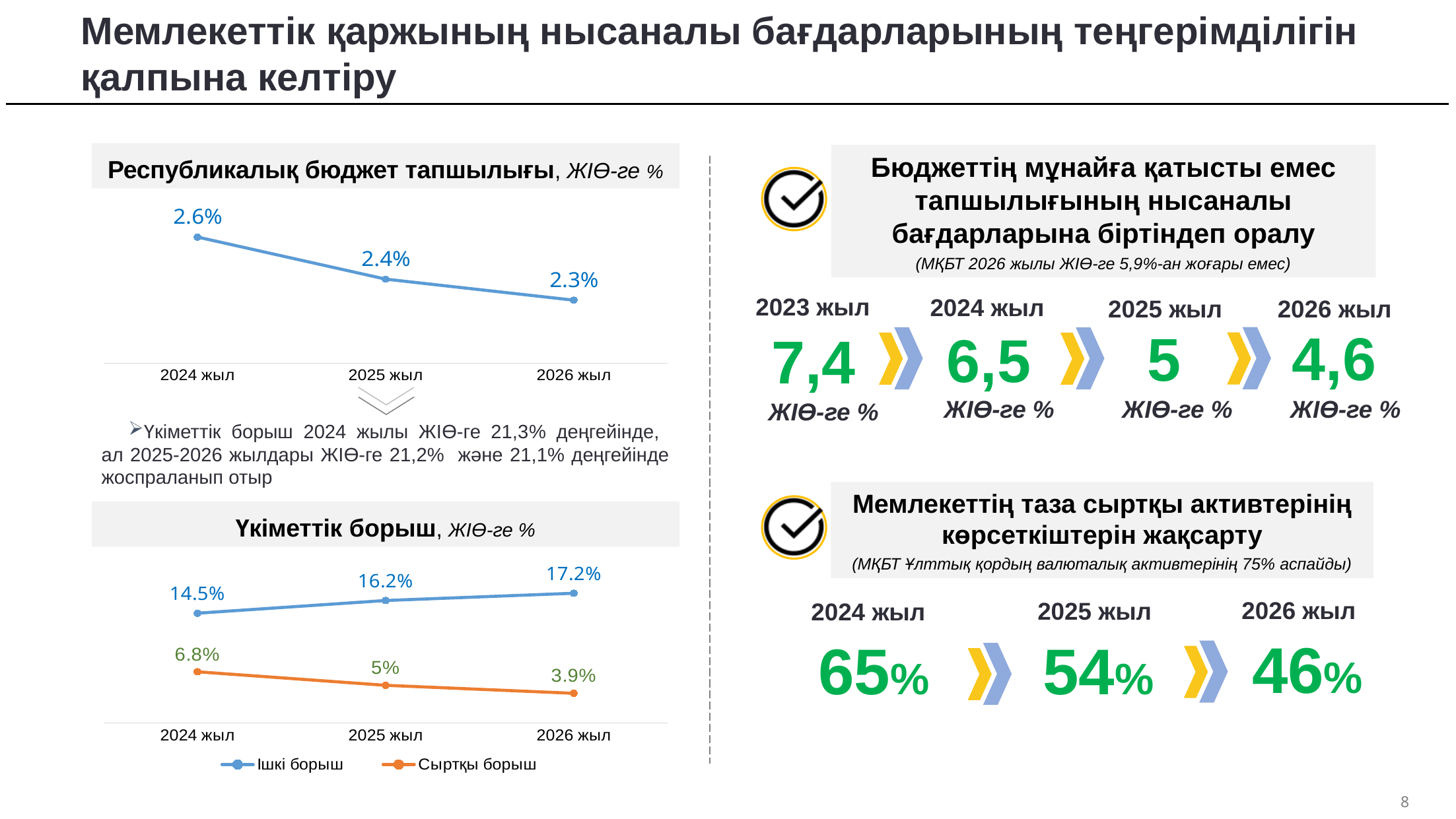
In the 'Республикалық бюджет тапшылығы' chart, what is the value for 2024 жыл? 2.6% In the 'Республикалық бюджет тапшылығы' chart, what is the value for 2026 жыл? 2.3% In the 'Үкіметтік борыш' chart, which series is shown in orange? Сыртқы борыш In the 'Үкіметтік борыш' chart, what is the value of Сыртқы борыш for 2026 жыл? 3.9% In the 'Үкіметтік борыш' chart, how many series does the legend list? 2 In the 'Үкіметтік борыш' chart, which year has the highest value for Ішкі борыш? 2026 жыл In the 'Үкіметтік борыш' chart, which year has the lowest value for Сыртқы борыш? 2026 жыл In the 'Республикалық бюджет тапшылығы' chart, how many data points are plotted? 3 In the 'Республикалық бюджет тапшылығы' chart, do the values rise or fall from 2024 жыл to 2026 жыл? fall What kind of chart is the 'Үкіметтік борыш' chart? line chart In the 'Үкіметтік борыш' chart, what is the value of Ішкі борыш for 2025 жыл? 16.2% In the 'Үкіметтік борыш' chart, what is the difference between Ішкі борыш and Сыртқы борыш in 2024 жыл? 7.7%